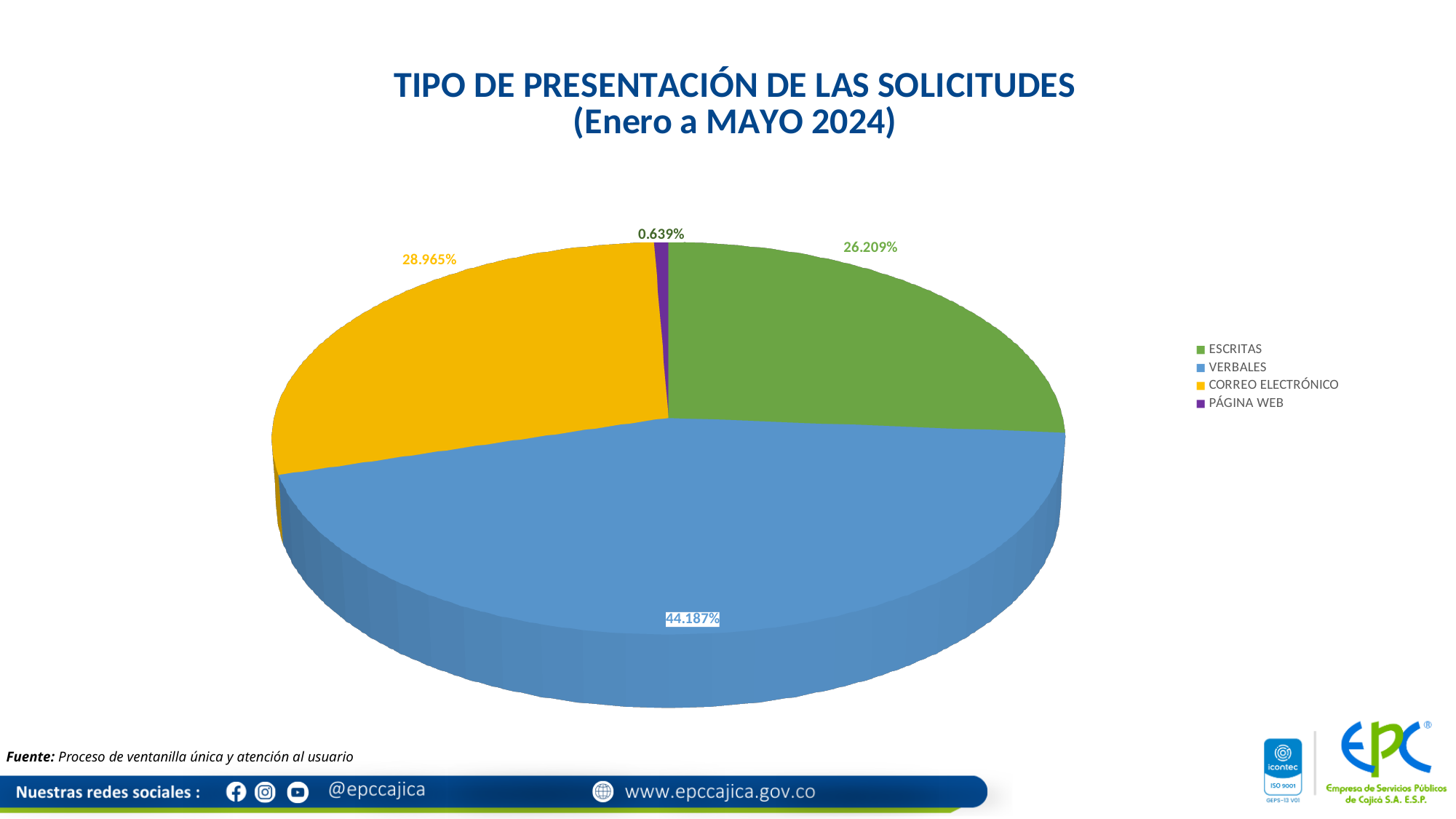
Which is larger, the share for CORREO ELECTRÓNICO or the share for ESCRITAS? CORREO ELECTRÓNICO What colour is the slice for CORREO ELECTRÓNICO? Yellow Which category has the largest share of the pie? VERBALES What percentage is shown for PÁGINA WEB? 0.639% What percentage of the pie does VERBALES represent? 44.187% What type of chart is shown on the slide? Pie chart What is the difference in percentage points between CORREO ELECTRÓNICO and ESCRITAS? 2.756 What is the difference in percentage points between VERBALES and ESCRITAS? 17.978 What percentage is shown for ESCRITAS? 26.209% Which category has the smallest share of the pie? PÁGINA WEB What percentage is shown for CORREO ELECTRÓNICO? 28.965% How many categories does the pie chart show? 4